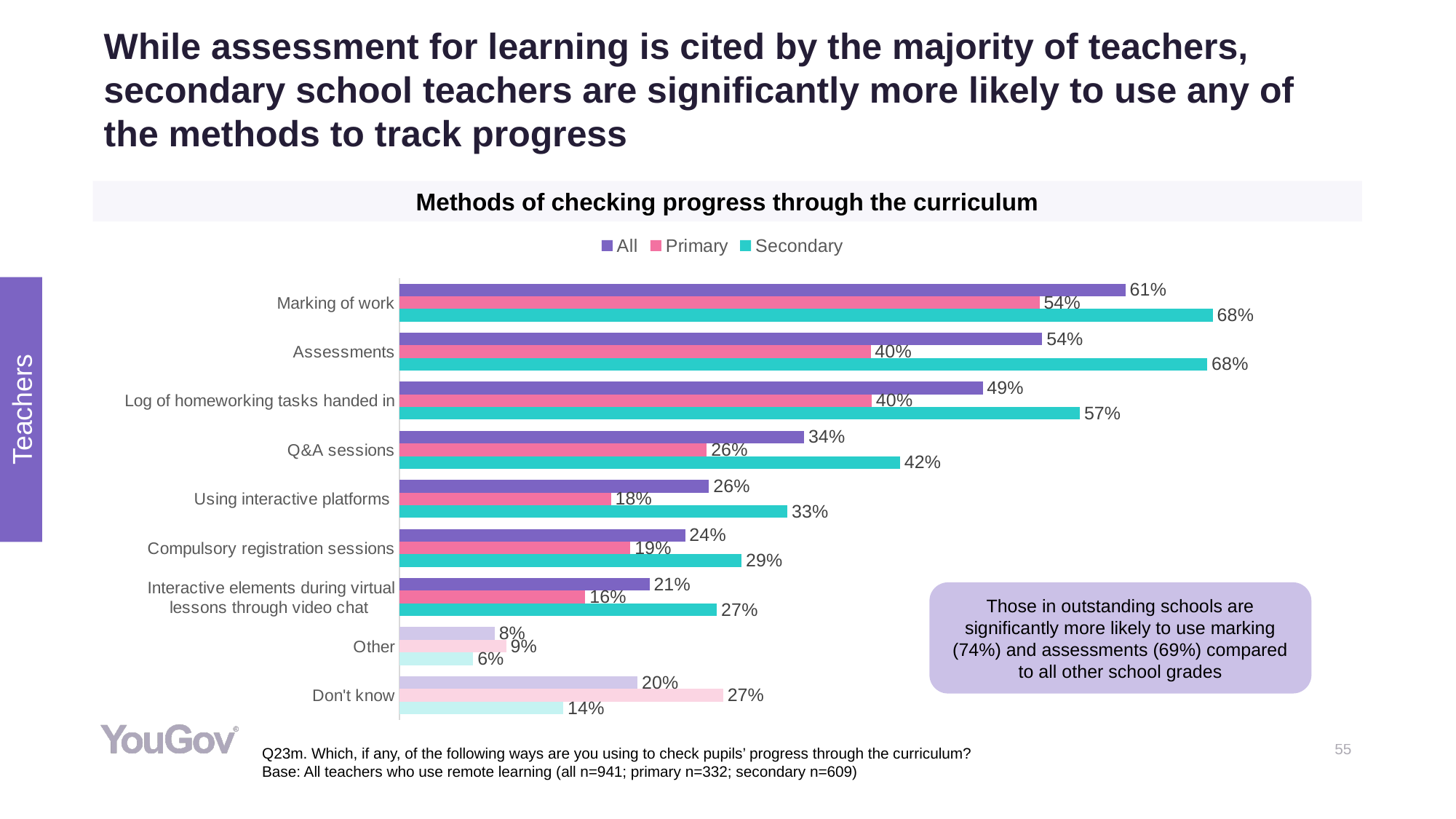
What is the Primary value for Don't know? 27% What is the Secondary value for Marking of work? 68% What is the All value for Q&A sessions? 34% How many categories are shown on the chart? 9 What is the title of the chart? Methods of checking progress through the curriculum What kind of chart is shown on the slide? Bar chart Which is larger for Using interactive platforms: the Primary value or the Secondary value? Secondary Which category has the highest All value? Marking of work What is the Primary value for Assessments? 40% How many series does the legend list? 3 What is the difference between the Secondary and Primary values for Assessments? 28% Which category has the lowest Secondary value? Other